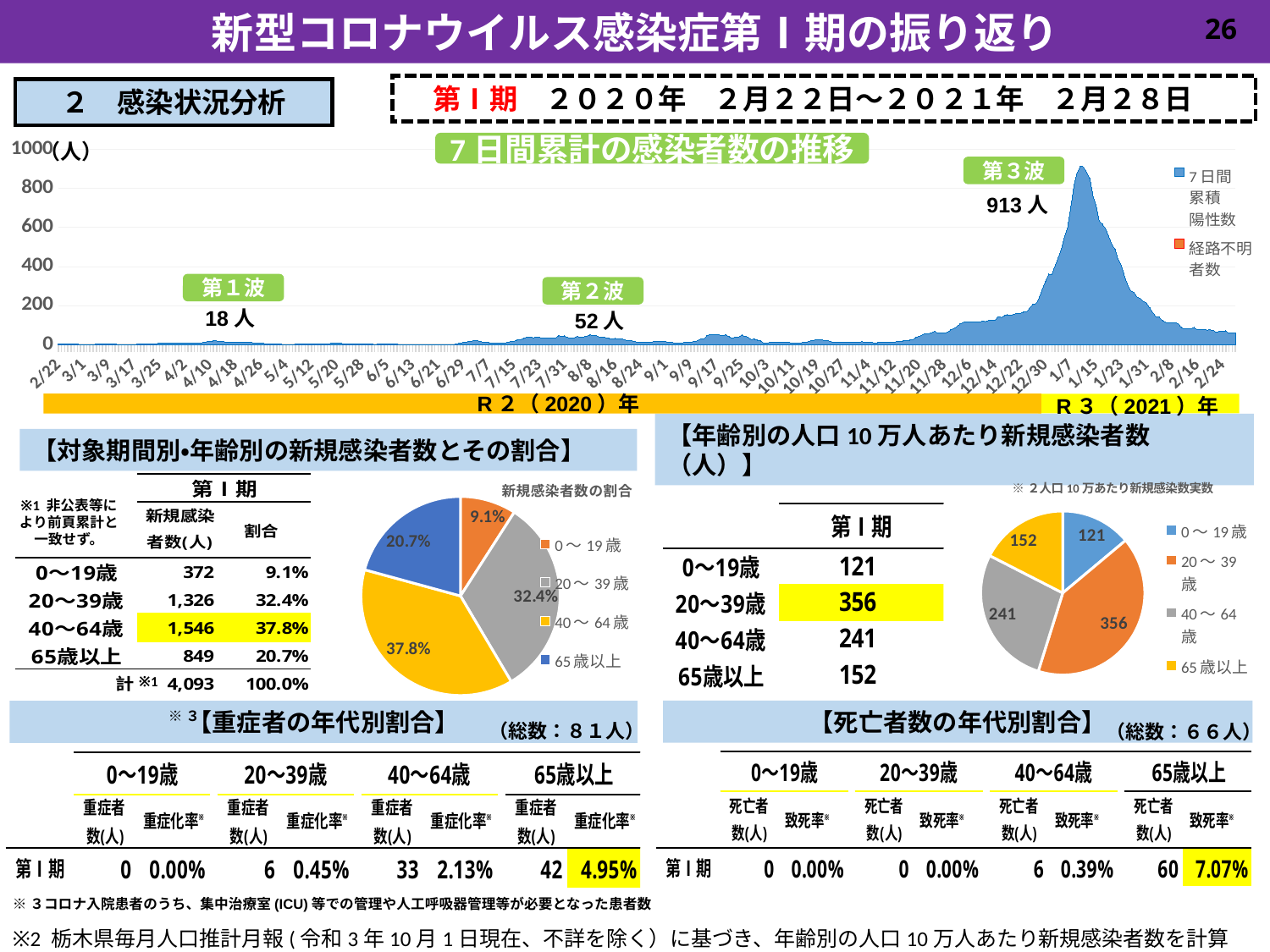
In the pie chart titled 「新規感染者数の割合」, which age group has the smallest share? 0〜19歳 What kind of chart is used under 「年齢別の人口10万人あたり新規感染者数」? pie chart In the area chart titled 「7日間累計の感染者数の推移」, what value is labeled for 第3波? 913人 In the pie chart under 「年齢別の人口10万人あたり新規感染者数」, what is the difference between the values for 20〜39歳 and 0〜19歳? 235 In the pie chart under 「年齢別の人口10万人あたり新規感染者数」, what is the value for 20〜39歳? 356 In the pie chart titled 「新規感染者数の割合」, what share does 40〜64歳 have? 37.8% In the area chart titled 「7日間累計の感染者数の推移」, is the peak of 第3波 greater or less than 800? greater In the area chart titled 「7日間累計の感染者数の推移」, how many series does the legend list? 2 In the area chart titled 「7日間累計の感染者数の推移」, what value is labeled for 第1波? 18人 In the pie chart titled 「新規感染者数の割合」, which is larger: the share for 20〜39歳 or the share for 65歳以上? 20〜39歳 In the area chart titled 「7日間累計の感染者数の推移」, which wave has the highest labeled peak? 第3波 In the pie chart titled 「新規感染者数の割合」, how many slices are there? 4